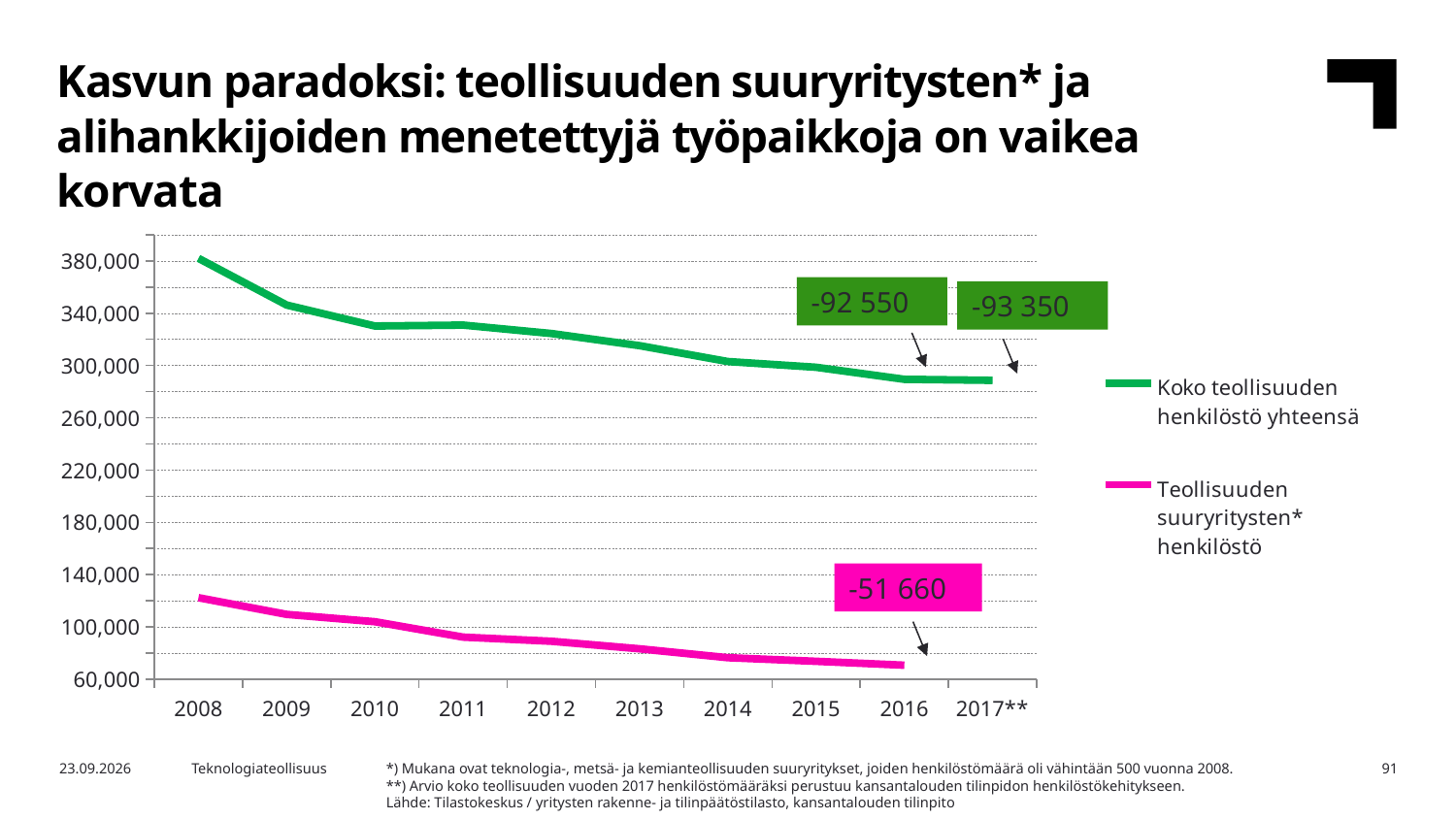
Is the value for 'Teollisuuden suuryritysten* henkilöstö' in 2008 greater or less than 100,000? greater Does the 'Koko teollisuuden henkilöstö yhteensä' series rise or fall from 2008 to 2017**? fall Is the value for 'Koko teollisuuden henkilöstö yhteensä' in 2016 greater or less than 300,000? less What kind of chart is shown on the slide? line chart What change is labelled on the pink series at 2016? -51 660 How many years are shown on the x axis? 10 In which year is the 'Koko teollisuuden henkilöstö yhteensä' series highest? 2008 What change is labelled on the green series at 2016? -92 550 Is the value for 'Teollisuuden suuryritysten* henkilöstö' in 2016 greater or less than 100,000? less In which year is the 'Teollisuuden suuryritysten* henkilöstö' series highest? 2008 In which year is the 'Teollisuuden suuryritysten* henkilöstö' series lowest? 2016 How many series does the legend list? 2